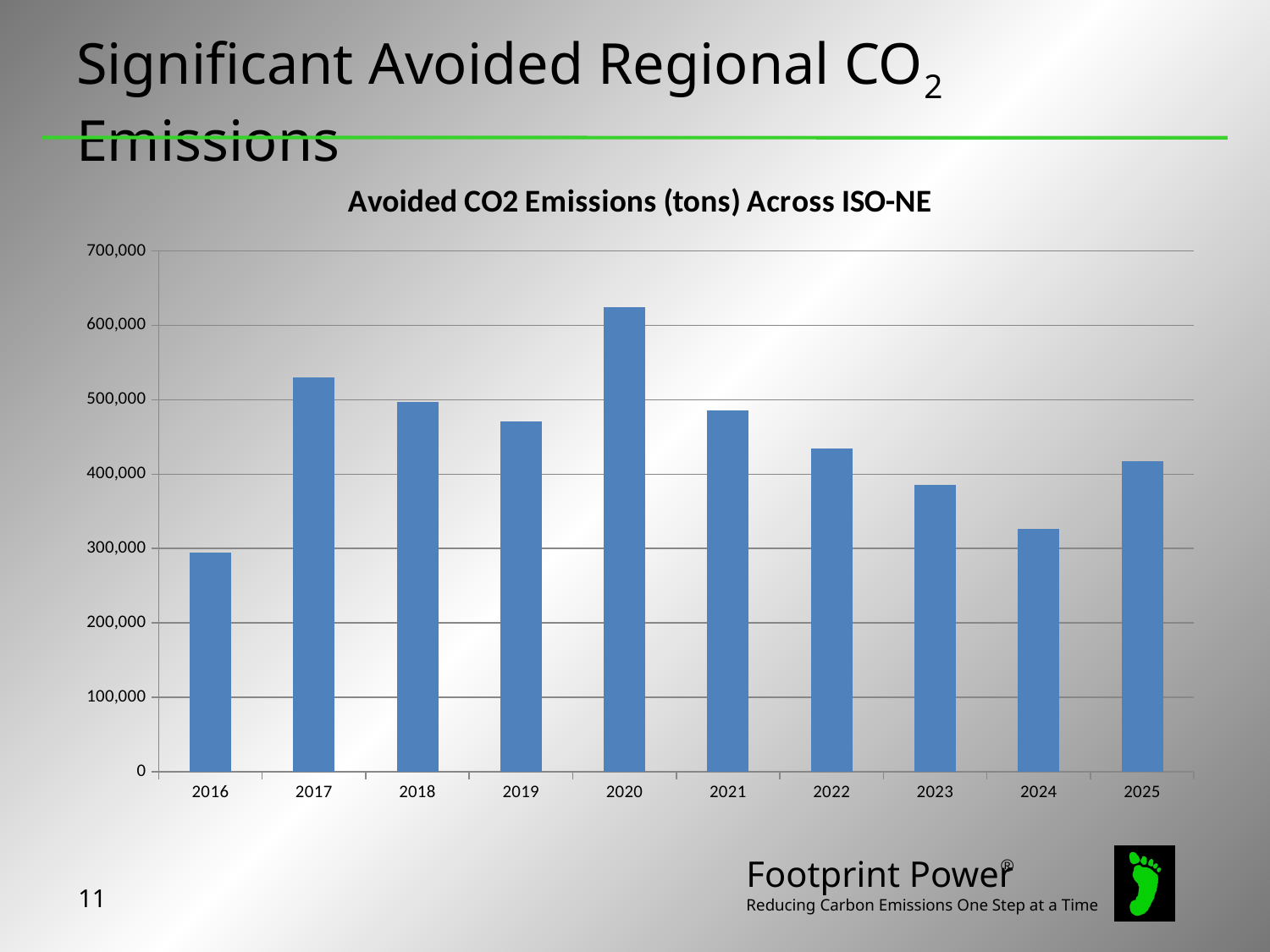
Which year has the lowest avoided CO2 emissions? 2016 Which year has the highest avoided CO2 emissions? 2020 Is the value for 2017 greater or less than 500,000? greater How many years are shown on the x axis of the chart? 10 Is the value for 2020 greater or less than 600,000? greater Which year has the larger value, 2017 or 2019? 2017 Which year has the larger value, 2023 or 2025? 2025 What type of chart is shown on the slide? bar chart Do the values rise or fall from 2020 to 2024? fall Is the value for 2024 greater or less than 400,000? less What is the title of the chart? Avoided CO2 Emissions (tons) Across ISO-NE